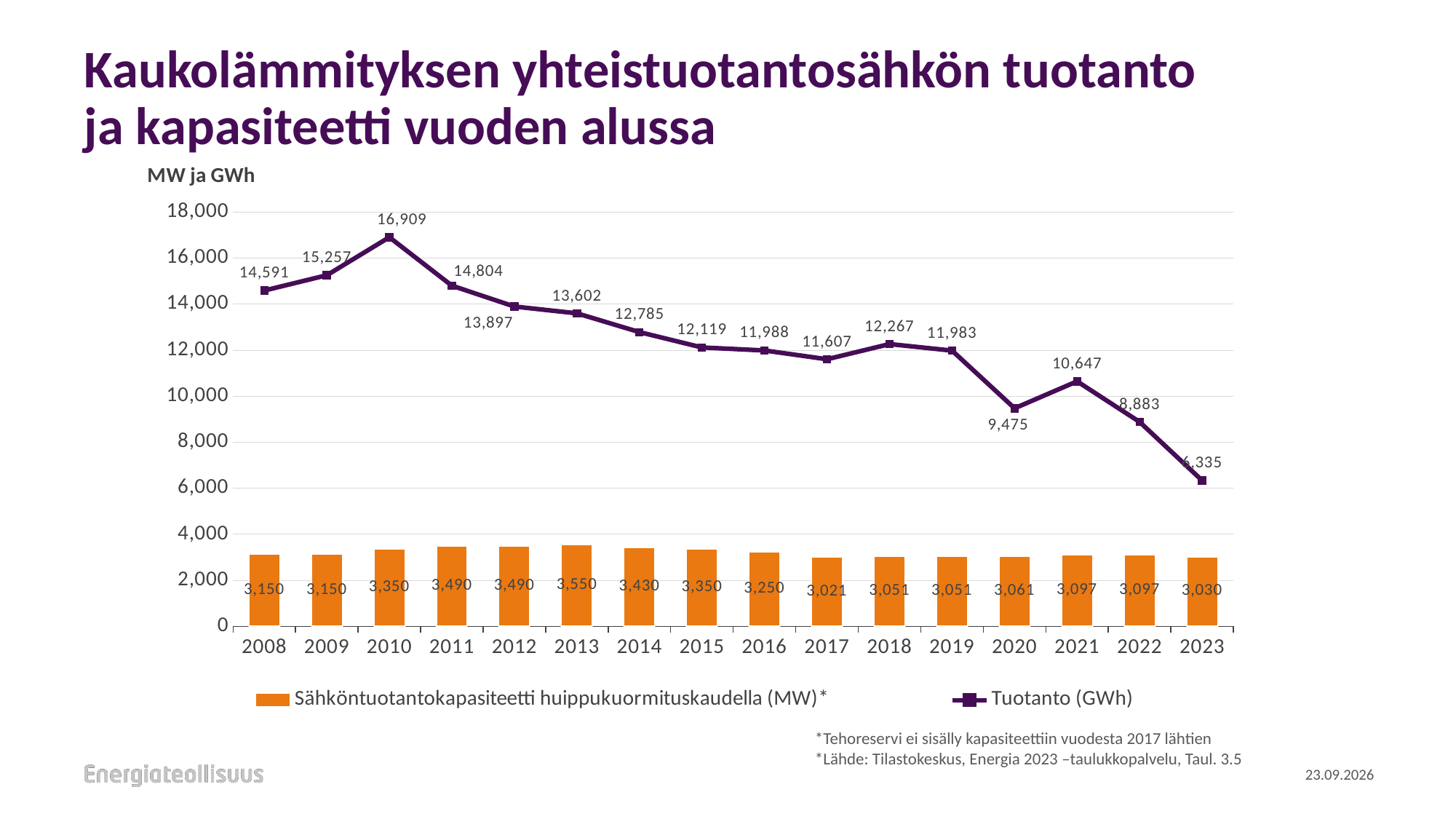
In which year is Tuotanto (GWh) lowest? 2023 What is the difference between the Tuotanto (GWh) values for 2010 and 2023? 10,574 Does Tuotanto (GWh) generally rise or fall from 2010 to 2023? Fall What kinds of chart are combined on this slide? Bar chart and line chart What is the Tuotanto (GWh) value for 2010? 16,909 How many series does the legend list? 2 What is the Tuotanto (GWh) value for 2023? 6,335 In which year is Tuotanto (GWh) highest? 2010 How many years are shown on the x axis? 16 What is the Sähköntuotantokapasiteetti huippukuormituskaudella (MW) value for 2013? 3,550 Which year has the larger Tuotanto (GWh) value, 2020 or 2021? 2021 In which year is Sähköntuotantokapasiteetti huippukuormituskaudella (MW) highest? 2013